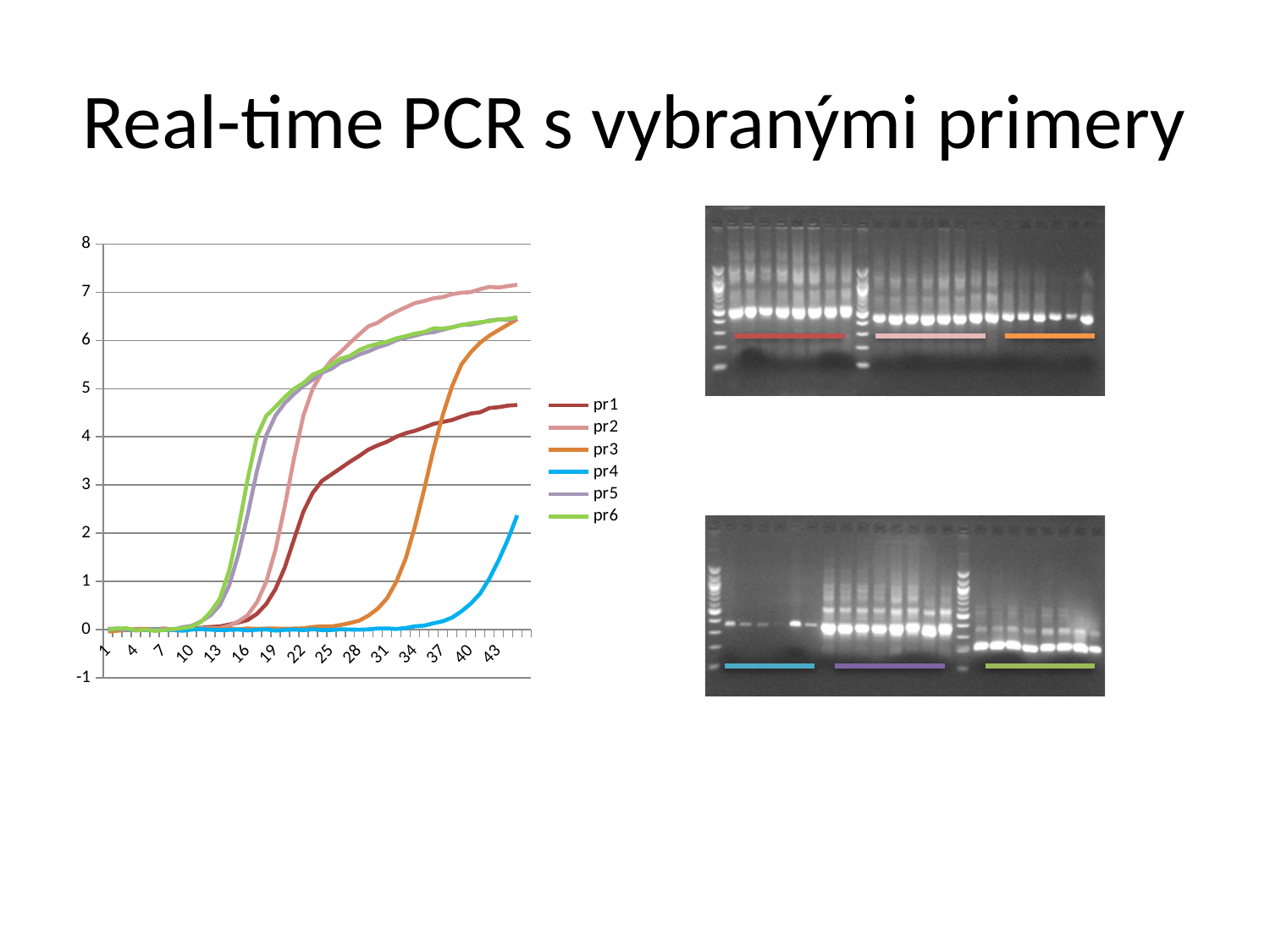
At the right end of the line chart, which series is higher, pr1 or pr2? pr2 Which series in the line chart has the lowest value at the right end of the x axis? pr4 Is the final value of pr1 in the line chart greater or less than 5? less Do the values of pr2 in the line chart rise or fall along the x axis? rise Is the final value of pr3 in the line chart greater or less than 6? greater How many series does the legend of the line chart list? 6 Which series in the line chart starts rising latest along the x axis? pr4 Is the final value of pr4 in the line chart greater or less than 3? less What kind of chart is shown on the left of the slide? line chart Which series in the line chart reaches the highest value at the right end of the x axis? pr2 What are the names of the series listed in the legend of the line chart? pr1, pr2, pr3, pr4, pr5, pr6